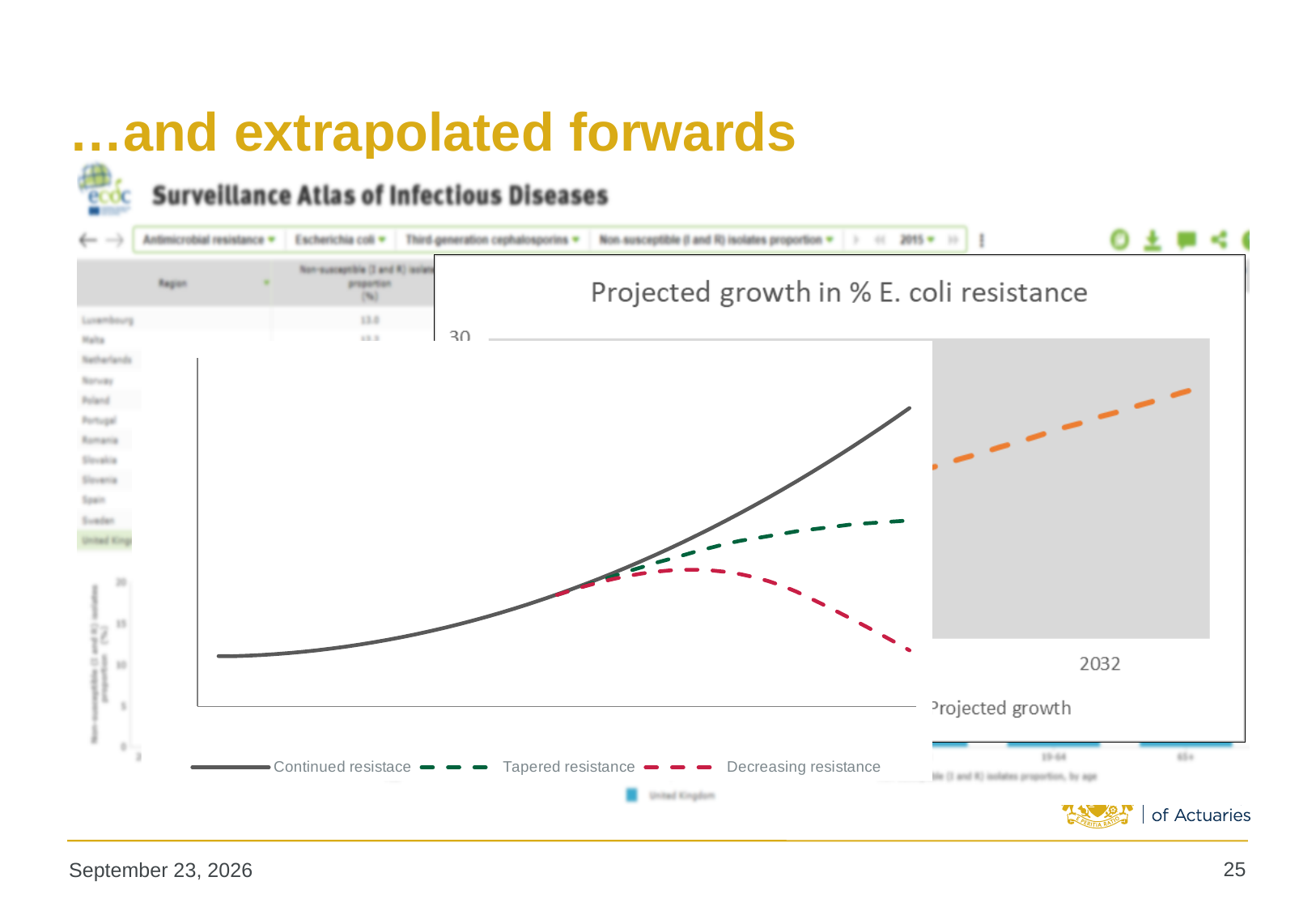
In the 'Projected growth in % E. coli resistance' chart, at the right end of the chart, which is higher: 'Continued resistace' or 'Tapered resistance'? Continued resistace In the 'Projected growth in % E. coli resistance' chart, does the 'Tapered resistance' line rise or fall along the x axis overall? rise In the 'Projected growth in % E. coli resistance' chart, does the 'Decreasing resistance' line rise or fall towards the right end of the chart? fall In the 'Projected growth in % E. coli resistance' chart, at the right end of the chart, which is higher: 'Tapered resistance' or 'Decreasing resistance'? Tapered resistance In the 'Projected growth in % E. coli resistance' chart, does the 'Continued resistace' line rise or fall along the x axis? rise What kind of chart is the overlaid chart titled 'Projected growth in % E. coli resistance'? line chart What are the three series named in the legend of the 'Projected growth in % E. coli resistance' chart? Continued resistace, Tapered resistance, Decreasing resistance What is the title of the overlaid line chart? Projected growth in % E. coli resistance In the 'Projected growth in % E. coli resistance' chart, which series is lowest at the right end of the chart? Decreasing resistance How many series does the legend of the 'Projected growth in % E. coli resistance' chart list? 3 In the 'Projected growth in % E. coli resistance' chart, which series is highest at the right end of the chart? Continued resistace